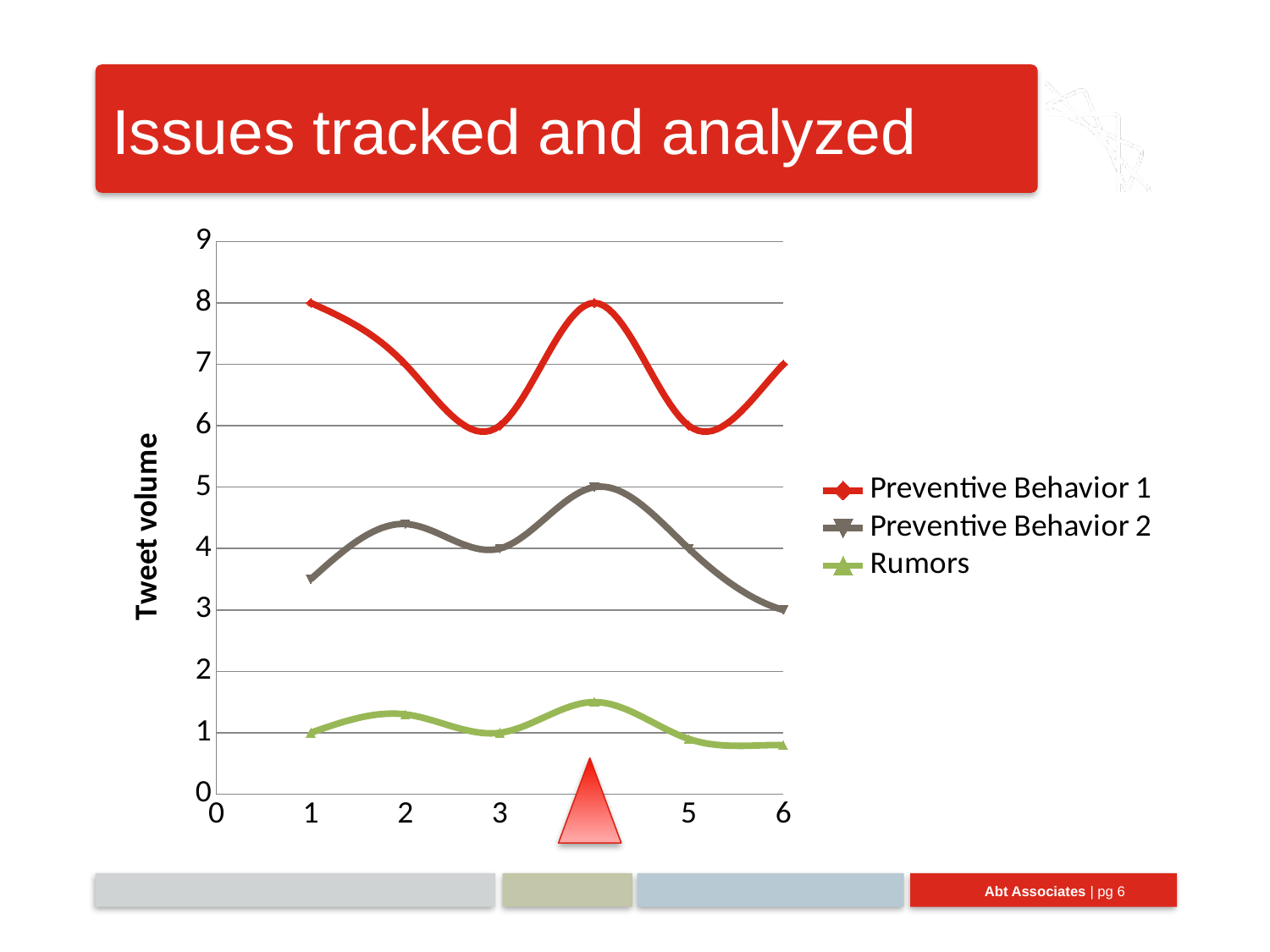
What is the value of Preventive Behavior 1 at x = 6? 7 At x = 6, which series has the larger value, Preventive Behavior 1 or Preventive Behavior 2? Preventive Behavior 1 Which series has the lowest tweet volume across the chart? Rumors What is the difference between Preventive Behavior 1 at x = 1 and at x = 6? 1 Is the value for Rumors at x = 6 greater or less than 1? less What is the value of Preventive Behavior 2 at x = 6? 3 Which series has the highest tweet volume across the chart? Preventive Behavior 1 What is the value of Rumors at x = 1? 1 What kind of chart is shown on the slide? line chart What is the value of Preventive Behavior 1 at x = 1? 8 How many series does the legend list? 3 Is the value for Preventive Behavior 2 at x = 1 greater or less than 3? greater